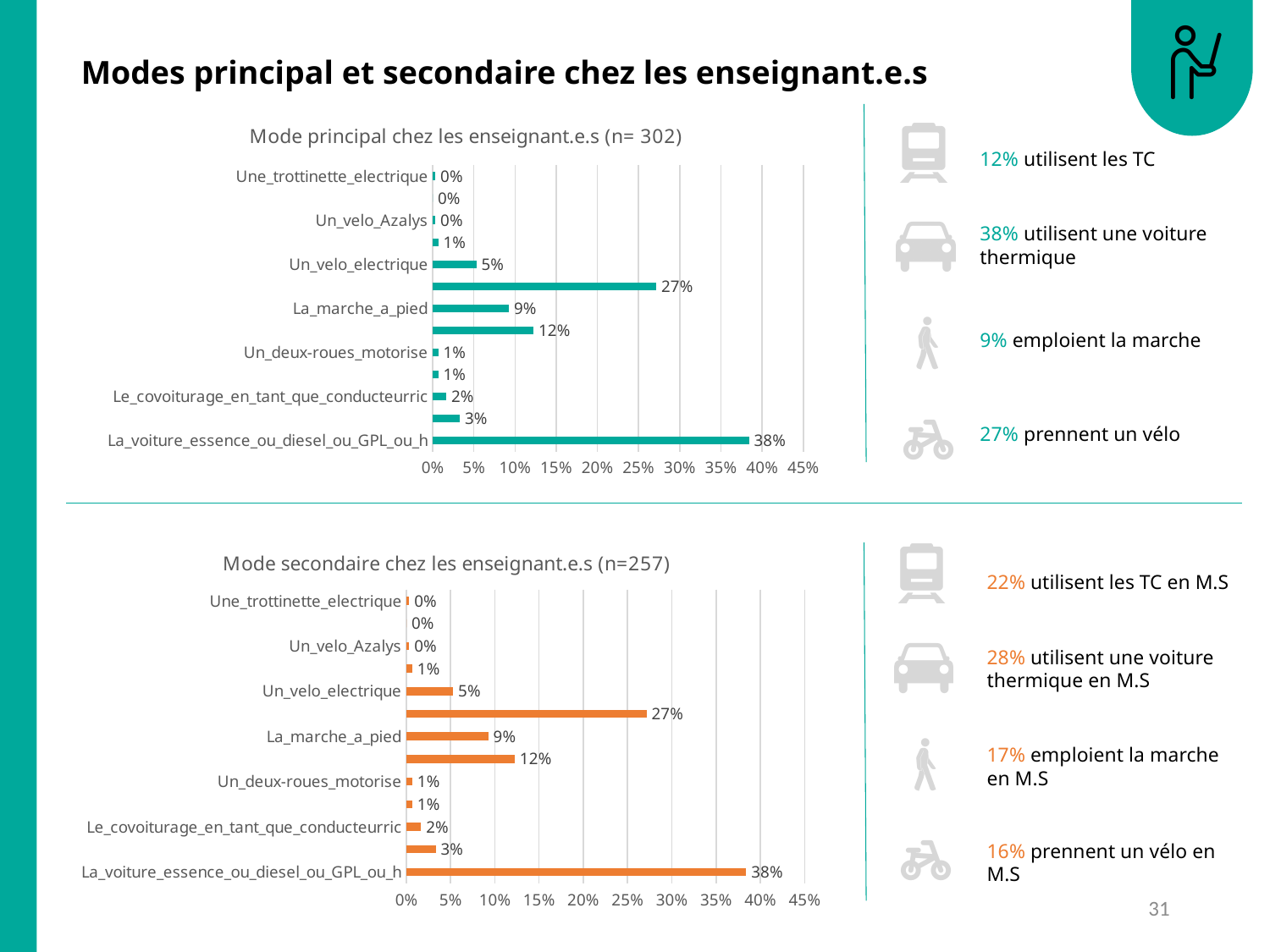
What colour are the bars in the chart titled "Mode secondaire chez les enseignant.e.s (n=257)"? Orange In the chart titled "Mode secondaire chez les enseignant.e.s (n=257)", what is the value for Un_deux-roues_motorise? 1% In the chart titled "Mode secondaire chez les enseignant.e.s (n=257)", what is the value for Le_covoiturage_en_tant_que_conducteurrice? 2% How many bars are plotted in the chart titled "Mode secondaire chez les enseignant.e.s (n=257)"? 13 In the chart titled "Mode secondaire chez les enseignant.e.s (n=257)", is the value for La_voiture_essence_ou_diesel_ou_GPL_ou_h greater or less than 35%? greater In the chart titled "Mode principal chez les enseignant.e.s (n= 302)", what is the difference between La_voiture_essence_ou_diesel_ou_GPL_ou_h and La_marche_a_pied? 29% In the chart titled "Mode principal chez les enseignant.e.s (n= 302)", what is the value for La_marche_a_pied? 9% In the chart titled "Mode principal chez les enseignant.e.s (n= 302)", what is the value for Un_velo_electrique? 5% In the chart titled "Mode principal chez les enseignant.e.s (n= 302)", which category has the highest value? La_voiture_essence_ou_diesel_ou_GPL_ou_h In the chart titled "Mode principal chez les enseignant.e.s (n= 302)", which is larger: Un_velo_electrique or Le_covoiturage_en_tant_que_conducteurrice? Un_velo_electrique What kind of chart is the chart titled "Mode principal chez les enseignant.e.s (n= 302)"? Bar chart In the chart titled "Mode principal chez les enseignant.e.s (n= 302)", what is the value for La_voiture_essence_ou_diesel_ou_GPL_ou_h? 38%